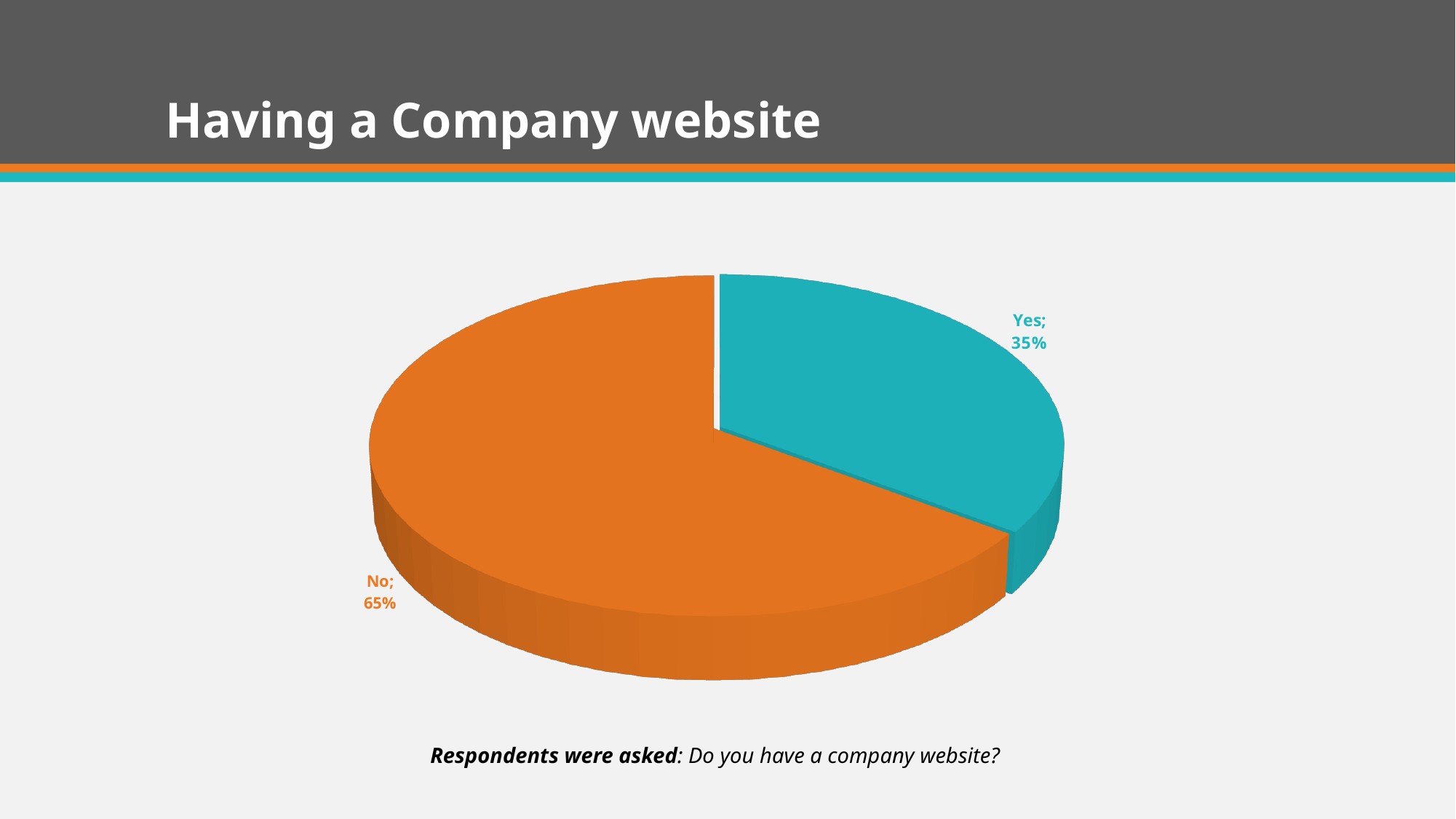
What percentage of respondents answered No to having a company website? 65% What kind of chart is shown on the slide? pie chart What percentage of respondents answered Yes to having a company website? 35% How many slices does the pie chart have? 2 Is the share for Yes greater or less than 50%? less What colour is the Yes slice of the pie chart? teal What is the difference in percentage points between the No and Yes slices? 30 What is the title of the slide containing the chart? Having a Company website Which response has the smallest share of the pie? Yes Which response has the largest share of the pie? No What share of the pie does the No slice represent? 65% Which slice is larger, Yes or No? No